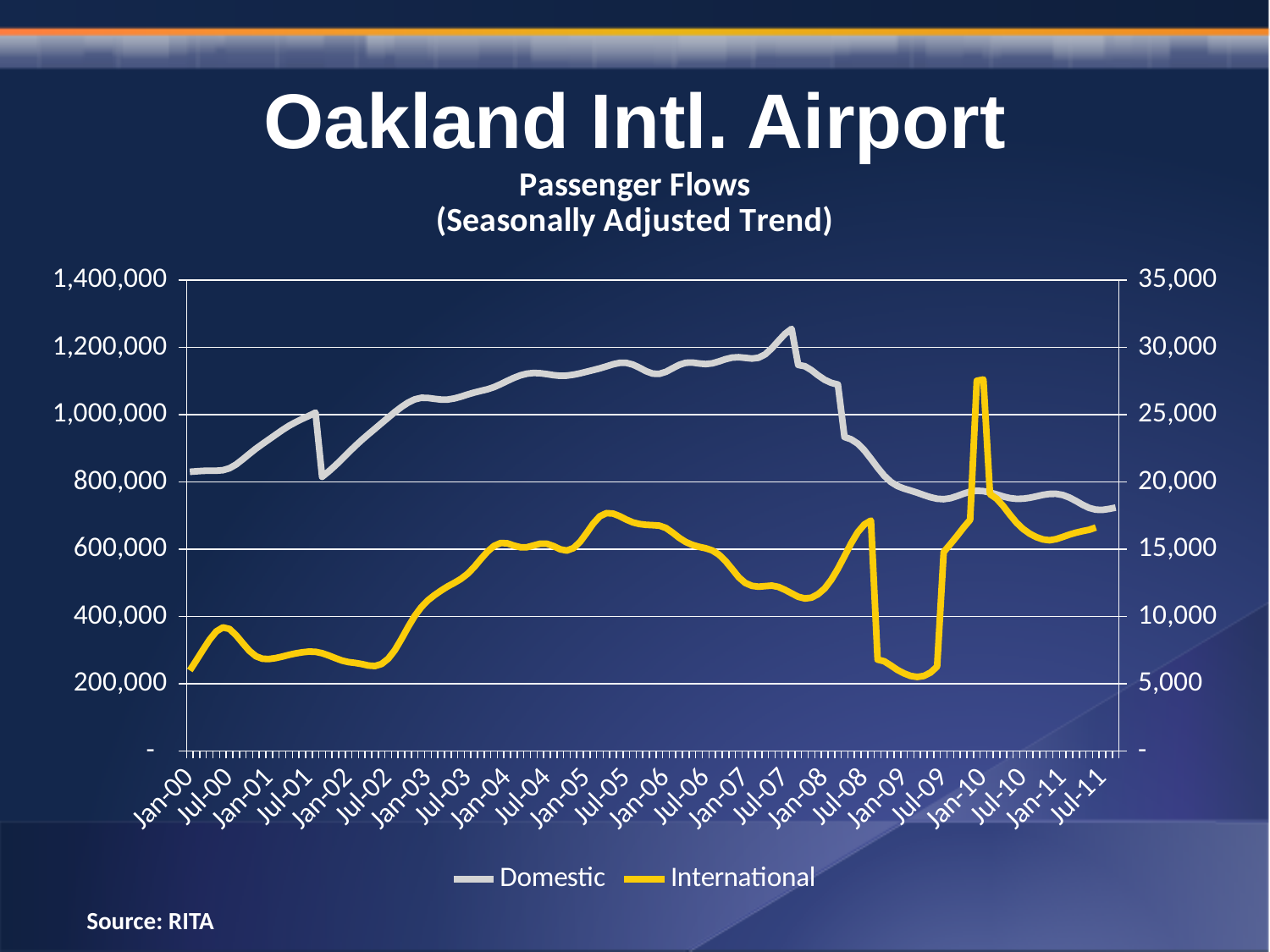
How many series does the legend list? 2 Is the Domestic value at Jul-07 greater or less than 1,200,000 on the left axis? greater Does the International line rise or fall between Jul-08 and Jan-09? Fall What kind of chart is shown on the slide? Line chart Is the Domestic value at Jan-00 greater or less than 1,000,000 on the left axis? less Is the International value at Jul-05 greater or less than 15,000 on the right axis? greater What is the title of the chart? Passenger Flows (Seasonally Adjusted Trend) Does the Domestic line rise or fall between Jan-08 and Jan-09? Fall Does the Domestic line rise or fall between Jan-02 and Jan-05? Rise What are the two series named in the legend? Domestic and International